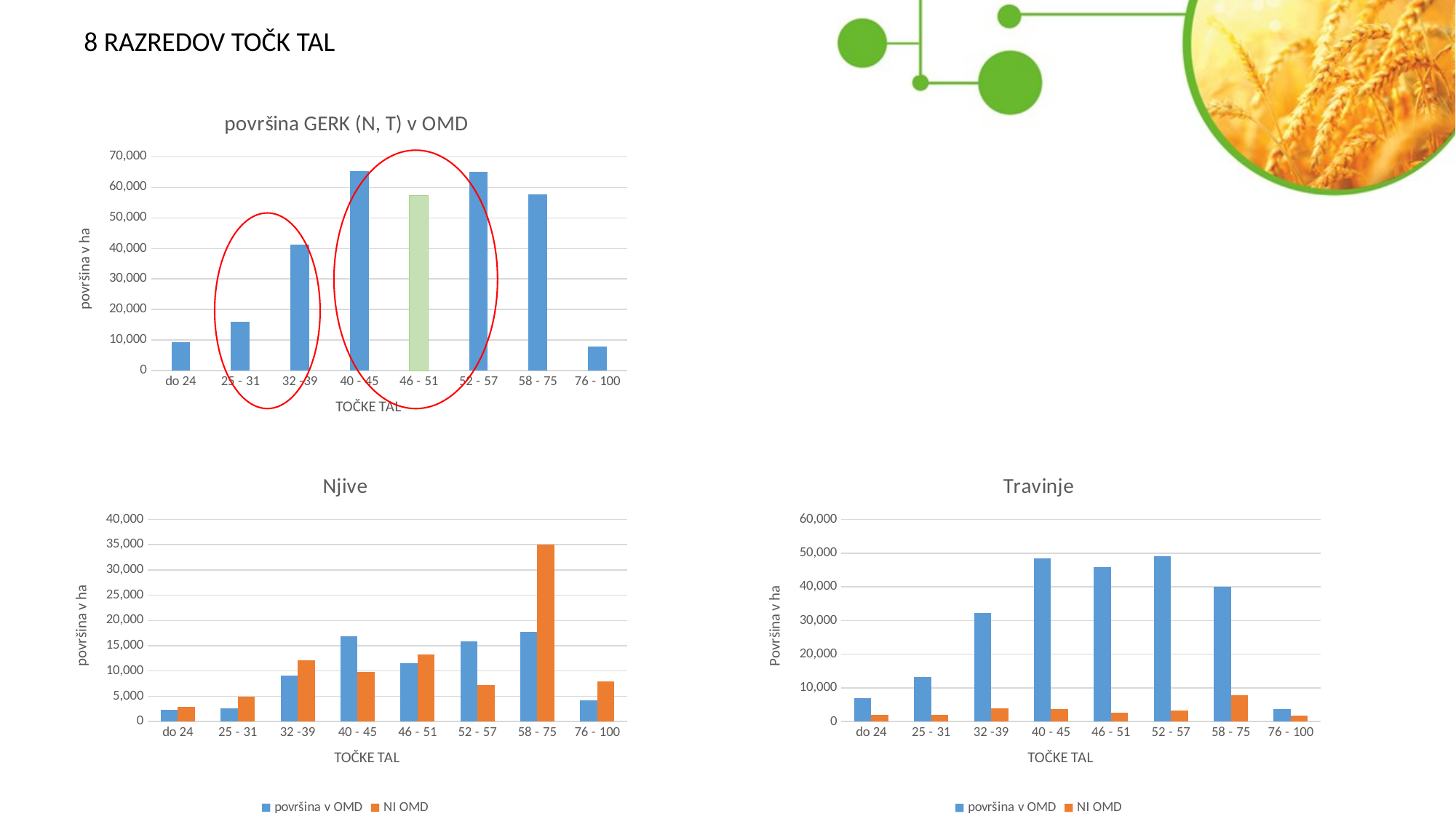
What kind of chart is the top chart titled "površina GERK (N, T) v OMD"? bar chart What is the x-axis title of the "Travinje" chart? TOČKE TAL In the top chart "površina GERK (N, T) v OMD", which has the larger value: 32 -39 or 25 - 31? 32 -39 In the "Travinje" chart, which category has the highest value for the NI OMD series? 58 - 75 In the "Njive" chart, for the category 58 - 75, which series has the larger value: površina v OMD or NI OMD? NI OMD In the top chart "površina GERK (N, T) v OMD", is the value for 40 - 45 greater or less than 60,000? greater In the top chart "površina GERK (N, T) v OMD", is the value for 25 - 31 greater or less than 20,000? less In the "Njive" chart, is the NI OMD value for 58 - 75 greater or less than 30,000? greater In the "Njive" chart, how many series does the legend list? 2 In the "Njive" chart, which category has the highest value for the NI OMD series? 58 - 75 In the top chart "površina GERK (N, T) v OMD", how many categories are shown on the x axis? 8